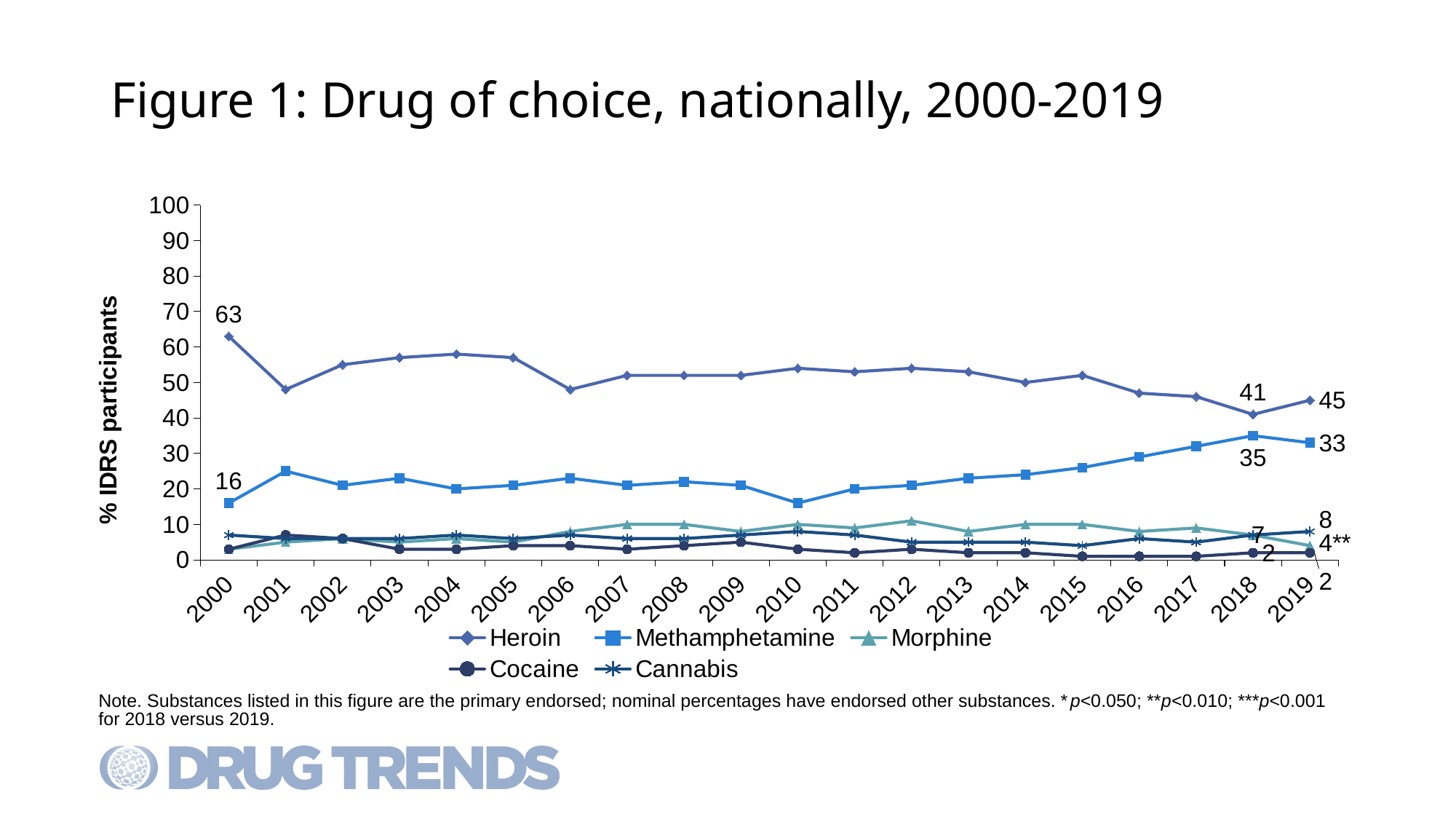
Is the value for Heroin in 2010 greater or less than 50? greater By how much did the Heroin value fall from 2000 to 2019? 18 What was the value for Heroin in 2000? 63 By how much did the Methamphetamine value rise from 2000 to 2019? 17 What kind of chart is shown on the slide? line chart How many years are plotted along the x axis? 20 What was the value for Heroin in 2018? 41 What was the value for Methamphetamine in 2019? 33 In 2019, which is larger: Heroin or Methamphetamine? Heroin Does the Methamphetamine line rise or fall between 2010 and 2018? rise What was the value for Cannabis in 2019? 8 How many series does the legend list? 5